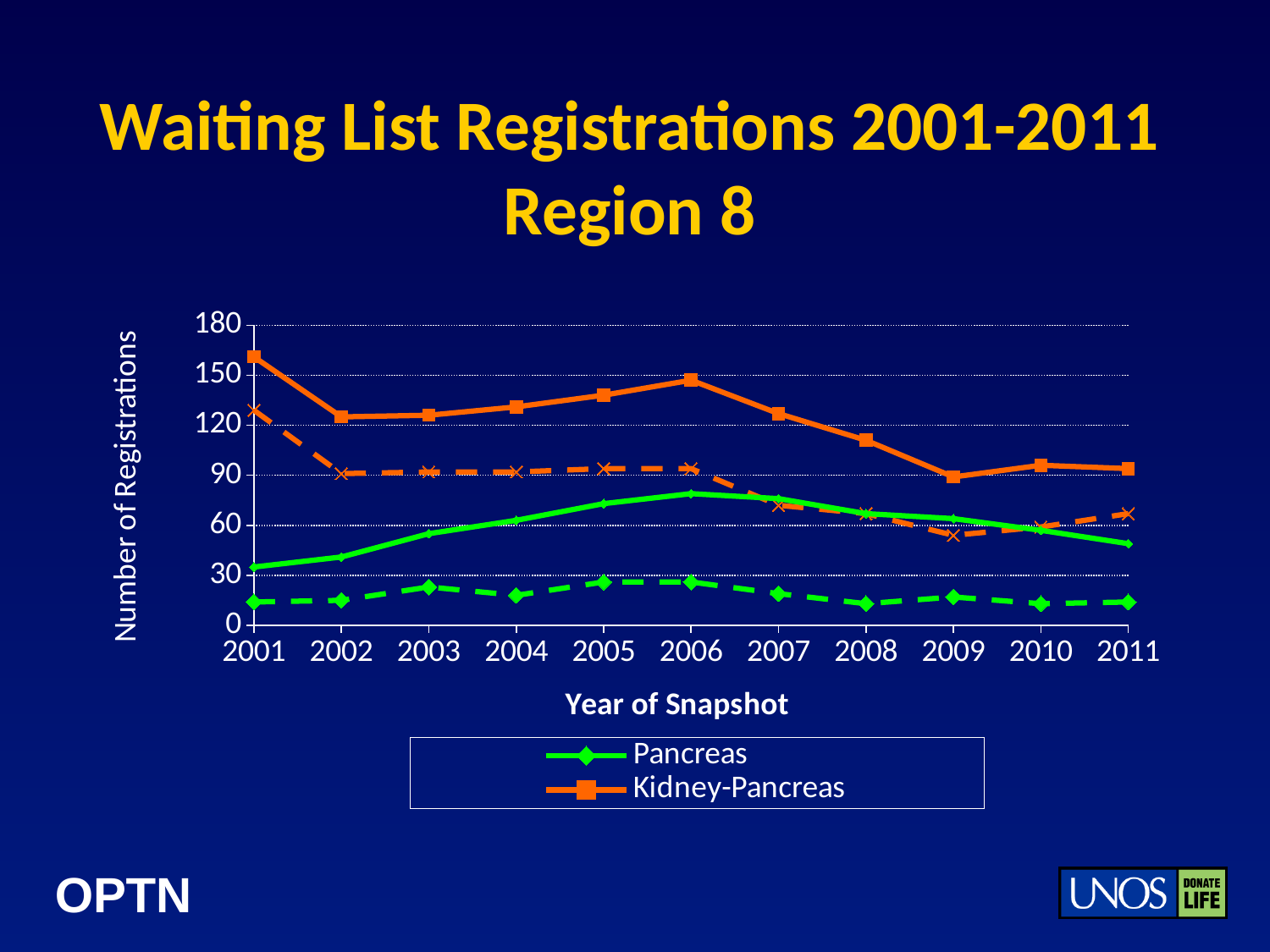
In which year is the solid Kidney-Pancreas line at its highest? 2001 In 2001, which solid line is higher: Pancreas or Kidney-Pancreas? Kidney-Pancreas What kind of chart is shown on the slide? line chart How many years are plotted along the x axis? 11 In which year is the solid Kidney-Pancreas line at its lowest? 2009 What is the title of the x axis? Year of Snapshot In which year does the solid Pancreas line reach its highest value? 2006 Is the solid Kidney-Pancreas value for 2001 greater or less than 150? greater Is the solid Kidney-Pancreas value for 2008 greater or less than 90? greater Is the solid Pancreas value for 2001 greater or less than 60? less How many series does the legend list? 2 Does the solid Pancreas line rise or fall from 2006 to 2011? fall